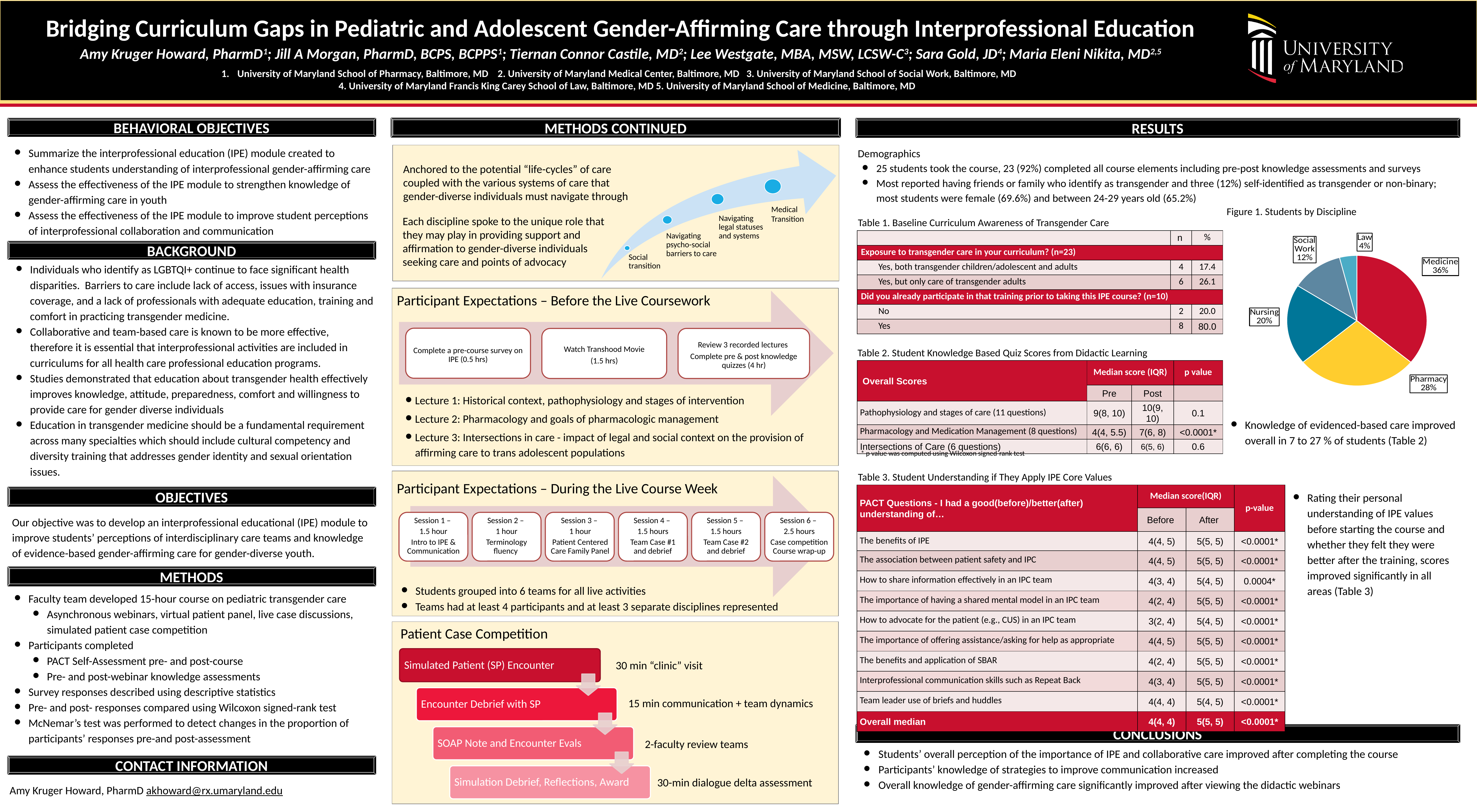
In the pie chart Figure 1. Students by Discipline, what percentage of students are from Medicine? 36% In the pie chart Figure 1. Students by Discipline, which has a larger share, Nursing or Social Work? Nursing In the pie chart Figure 1. Students by Discipline, what share of the pie does Social Work represent? 12% What kind of chart is Figure 1. Students by Discipline? Pie chart How many disciplines (slices) are shown in the pie chart Figure 1. Students by Discipline? 5 In the pie chart Figure 1. Students by Discipline, what percentage of students are from Law? 4% In the pie chart Figure 1. Students by Discipline, what percentage of students are from Nursing? 20% In the pie chart Figure 1. Students by Discipline, which discipline has the smallest share of students? Law In the pie chart Figure 1. Students by Discipline, how many percentage points larger is the Medicine share than the Pharmacy share? 8 percentage points What is the title of the chart in the Results section of the slide? Figure 1. Students by Discipline In the pie chart Figure 1. Students by Discipline, which discipline has the largest share of students? Medicine In the pie chart Figure 1. Students by Discipline, what percentage of students are from Pharmacy? 28%